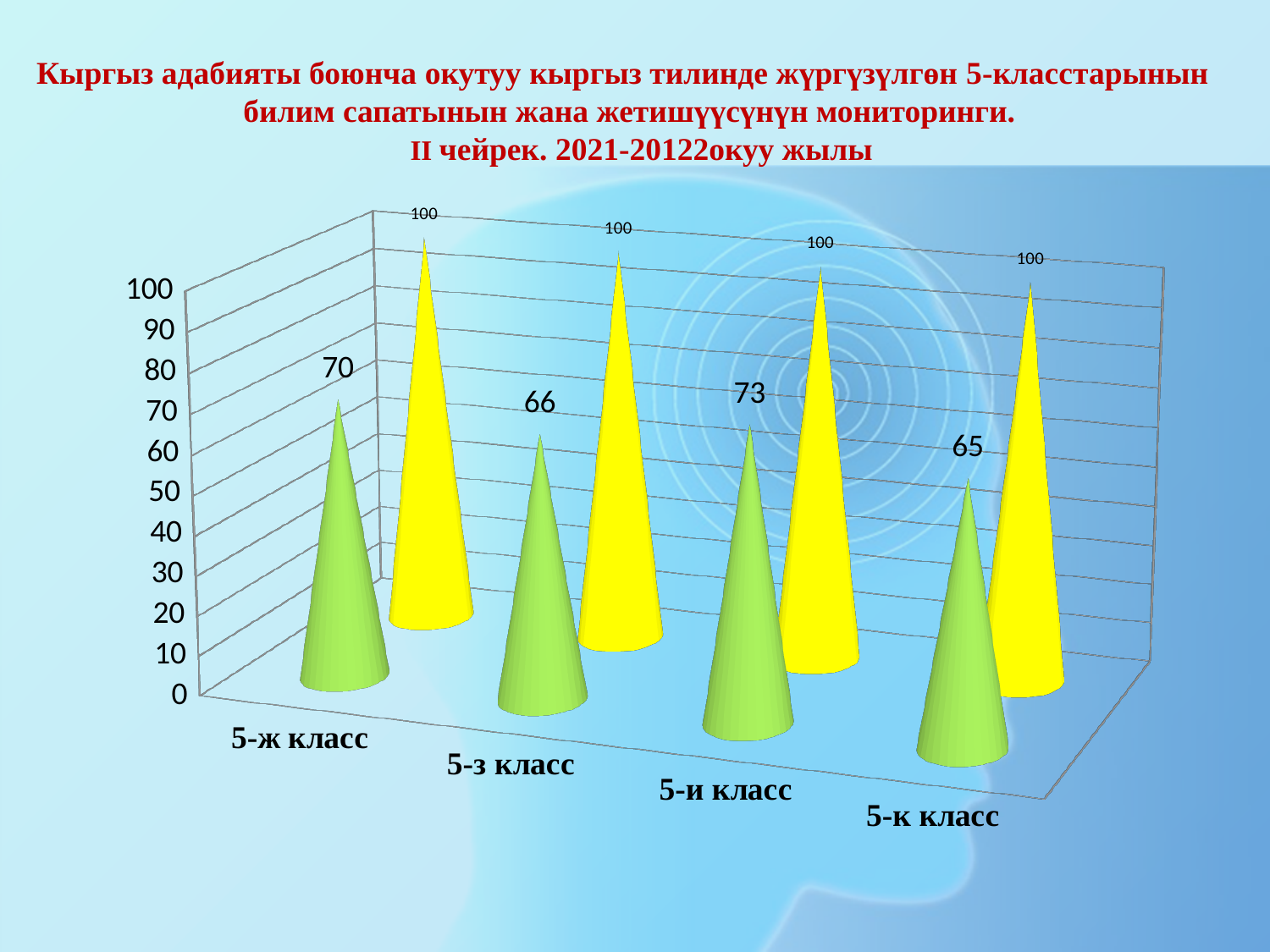
What is the value of the green cone for 5-з класс? 66 What is the value of the yellow cone for 5-з класс? 100 What is the value of the green cone for 5-ж класс? 70 What is the highest value shown on the vertical axis of the chart? 100 How many classes are shown on the x axis of the chart? 4 What is the value of the green cone for 5-к класс? 65 What is the difference between the green values for 5-и класс and 5-к класс? 8 Which class has the highest green cone value? 5-и класс What is the difference between the yellow and green values for 5-ж класс? 30 Which class has the lowest green cone value? 5-к класс What is the value of the green cone for 5-и класс? 73 Which is larger, the green value for 5-ж класс or for 5-з класс? 5-ж класс